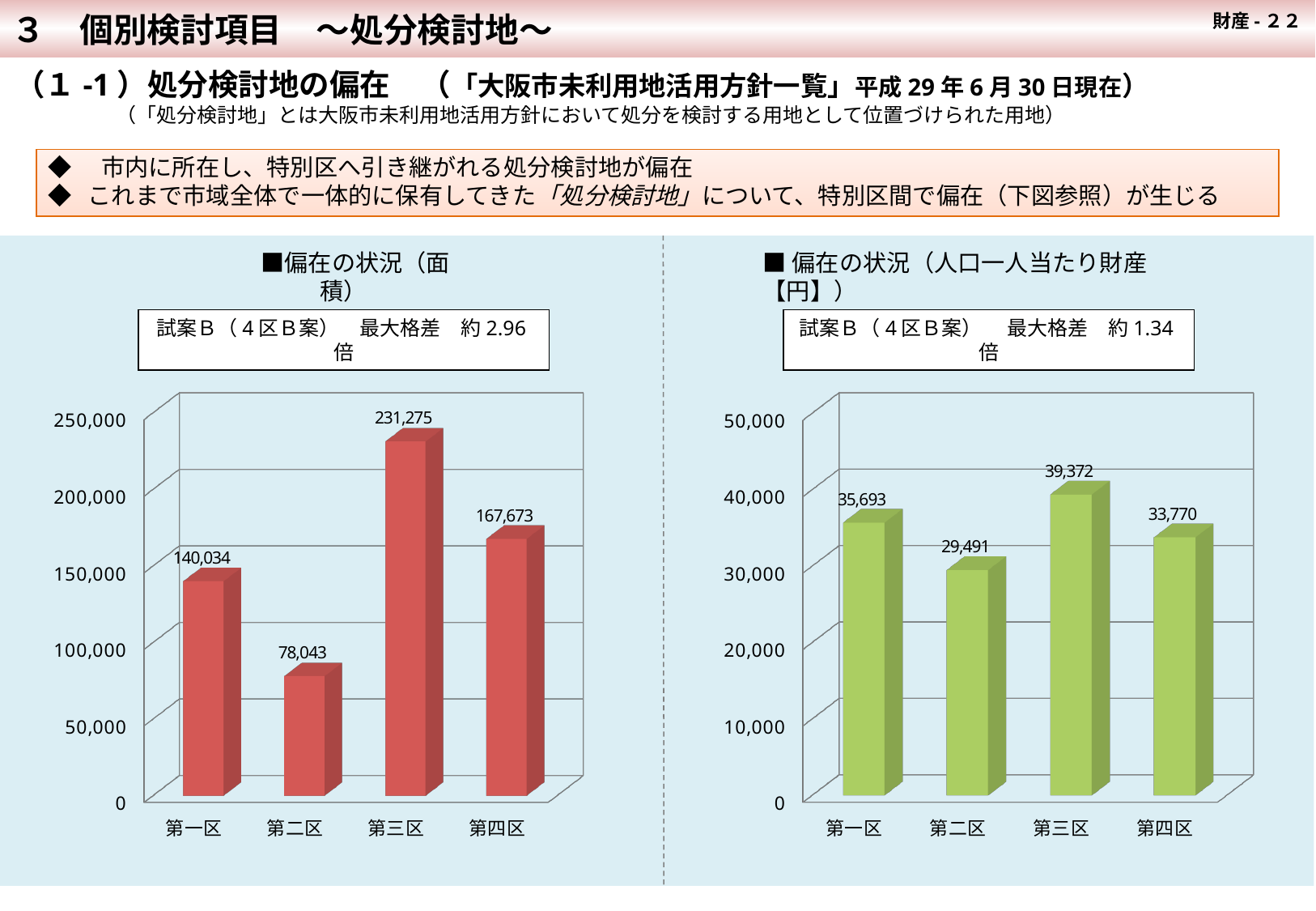
In the right chart (偏在の状況（人口一人当たり財産【円】）), what is the value for 第四区? 33,770 In the right chart (偏在の状況（人口一人当たり財産【円】）), which district has the lowest value? 第二区 In the right chart (偏在の状況（人口一人当たり財産【円】）), is the value for 第二区 greater or less than 30,000? less In the left chart (偏在の状況（面積）), what is the value for 第二区? 78,043 In the left chart (偏在の状況（面積）), what is the difference between the values for 第三区 and 第二区? 153,232 In the right chart (偏在の状況（人口一人当たり財産【円】）), what is the value for 第一区? 35,693 What kind of chart is the right chart (偏在の状況（人口一人当たり財産【円】）)? bar chart In the left chart (偏在の状況（面積）), which is larger, the value for 第一区 or 第四区? 第四区 How many districts are shown on the x axis of the left chart (偏在の状況（面積）)? 4 In the left chart (偏在の状況（面積）), what is the value for 第三区? 231,275 In the left chart (偏在の状況（面積）), which district has the highest value? 第三区 In the right chart (偏在の状況（人口一人当たり財産【円】）), what is the difference between the values for 第三区 and 第一区? 3,679